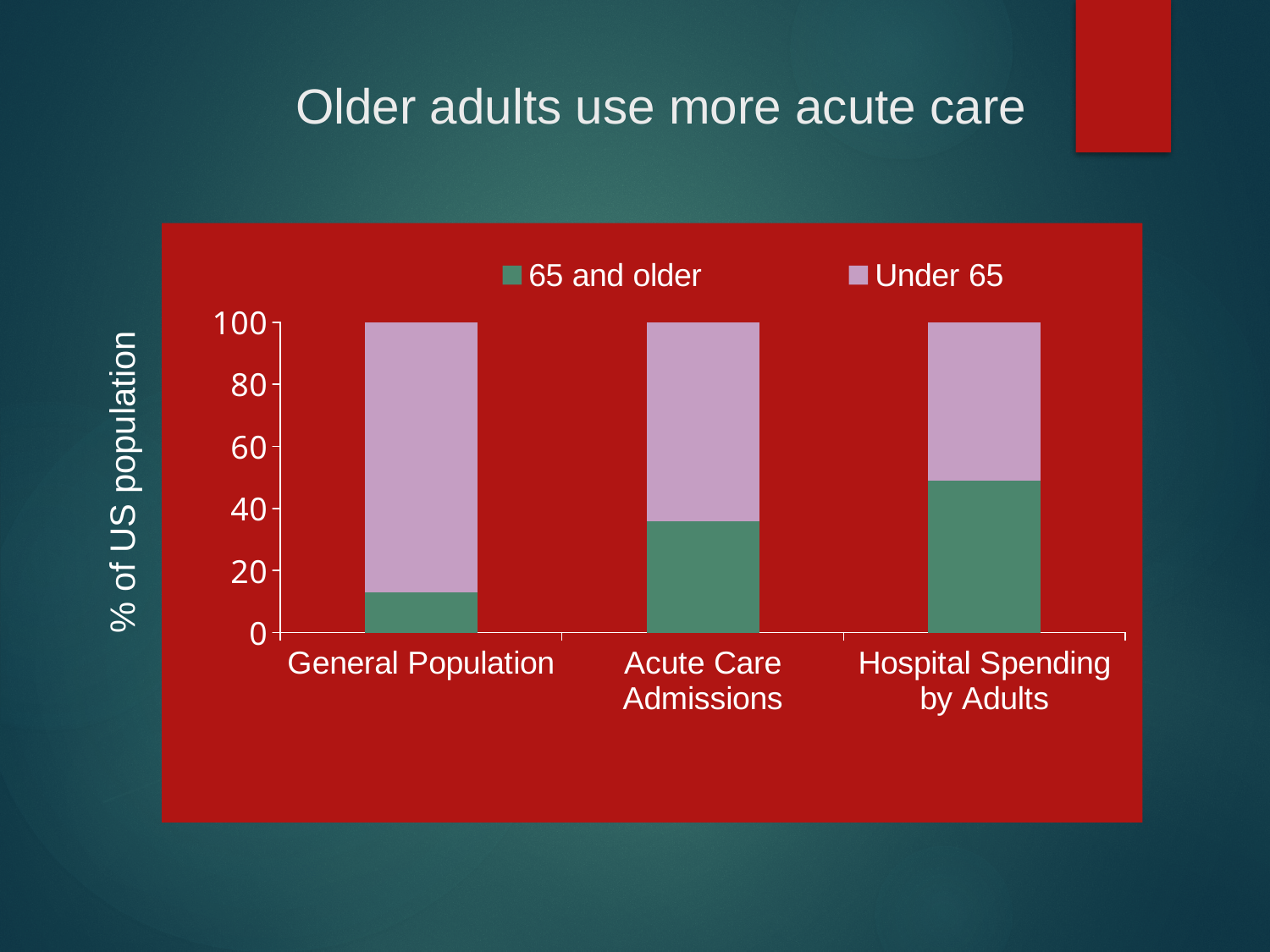
How many categories are shown on the x axis? 3 What is the title of the chart? Older adults use more acute care Is the '65 and older' value for Acute Care Admissions greater or less than 20? greater What kind of chart is shown on the slide? stacked bar chart Is the '65 and older' value for General Population greater or less than 20? less Which category has the smallest '65 and older' segment? General Population Is the '65 and older' value for Hospital Spending by Adults greater or less than 40? greater Which category has the largest '65 and older' segment? Hospital Spending by Adults What is the total height of the stacked bar for Acute Care Admissions? 100 Does the '65 and older' segment rise or fall moving left to right across the categories? rise How many series does the legend list? 2 Which is larger: the 'Under 65' segment for General Population or for Hospital Spending by Adults? General Population